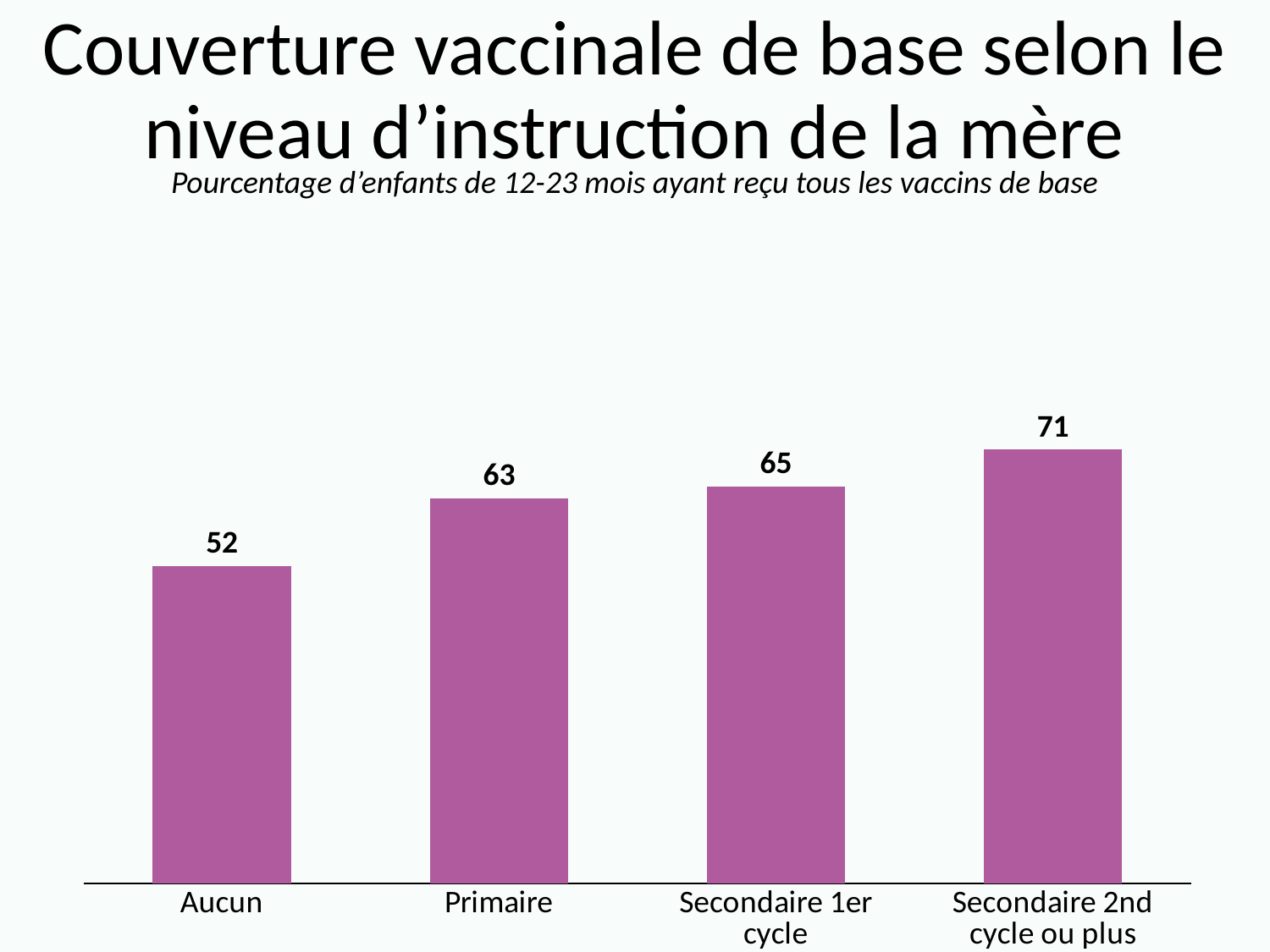
How many categories are shown on the chart? 4 What is the value for Aucun? 52 Do the values rise or fall from Aucun to Secondaire 2nd cycle ou plus? Rise Which is larger, the value for Primaire or the value for Secondaire 2nd cycle ou plus? Secondaire 2nd cycle ou plus What is the difference between the values for Primaire and Aucun? 11 What is the value for Primaire? 63 What kind of chart is shown on the slide? Bar chart What is the value for Secondaire 1er cycle? 65 What is the value for Secondaire 2nd cycle ou plus? 71 Which category has the lowest value? Aucun What is the difference between the values for Secondaire 2nd cycle ou plus and Aucun? 19 Which category has the highest value? Secondaire 2nd cycle ou plus